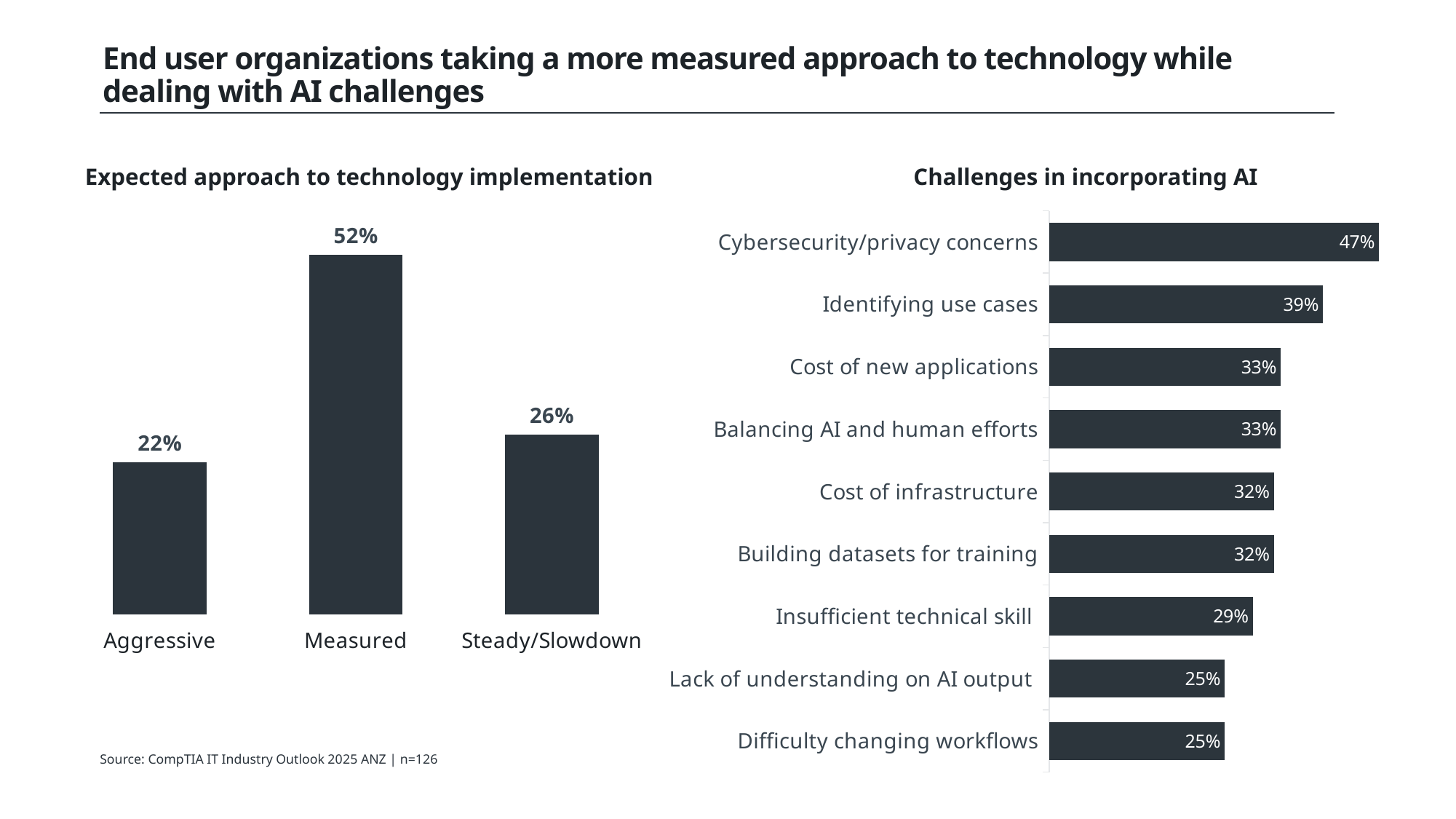
In the 'Challenges in incorporating AI' chart, what is the value for Identifying use cases? 39% In the 'Challenges in incorporating AI' chart, what is the difference between Cybersecurity/privacy concerns and Difficulty changing workflows? 22% In the 'Expected approach to technology implementation' chart, how many categories are shown? 3 What kind of chart is the 'Challenges in incorporating AI' chart? Bar chart In the 'Expected approach to technology implementation' chart, which category has the lowest value? Aggressive In the 'Expected approach to technology implementation' chart, what is the difference between Measured and Steady/Slowdown? 26% In the 'Expected approach to technology implementation' chart, what is the value for Measured? 52% In the 'Challenges in incorporating AI' chart, what is the value for Insufficient technical skill? 29% In the 'Challenges in incorporating AI' chart, which category has the highest value? Cybersecurity/privacy concerns In the 'Challenges in incorporating AI' chart, which is larger: Cost of new applications or Lack of understanding on AI output? Cost of new applications In the 'Expected approach to technology implementation' chart, what is the value for Aggressive? 22% In the 'Challenges in incorporating AI' chart, how many categories are shown? 9